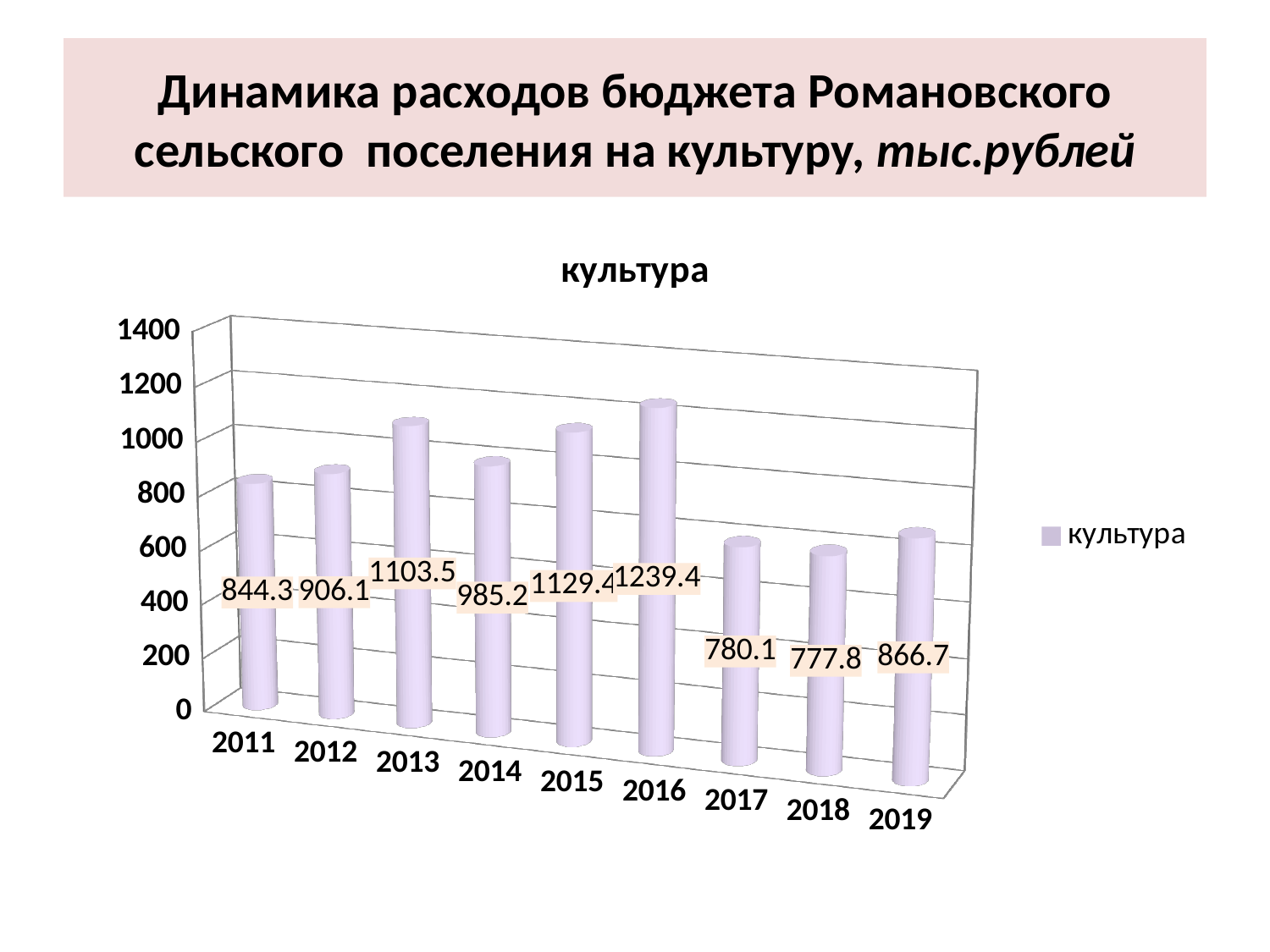
What is the title of the chart? культура What is the difference between the values for 2016 and 2011? 395.1 What is the value for 2016? 1239.4 How many series does the legend list? 1 Which is larger, the value for 2015 or the value for 2014? 2015 What is the value for 2013? 1103.5 What kind of chart is shown? bar chart Which year has the highest value? 2016 Is the value for 2017 greater or less than 1000? less What is the difference between the values for 2013 and 2012? 197.4 How many years are shown on the x axis? 9 What is the value for 2018? 777.8